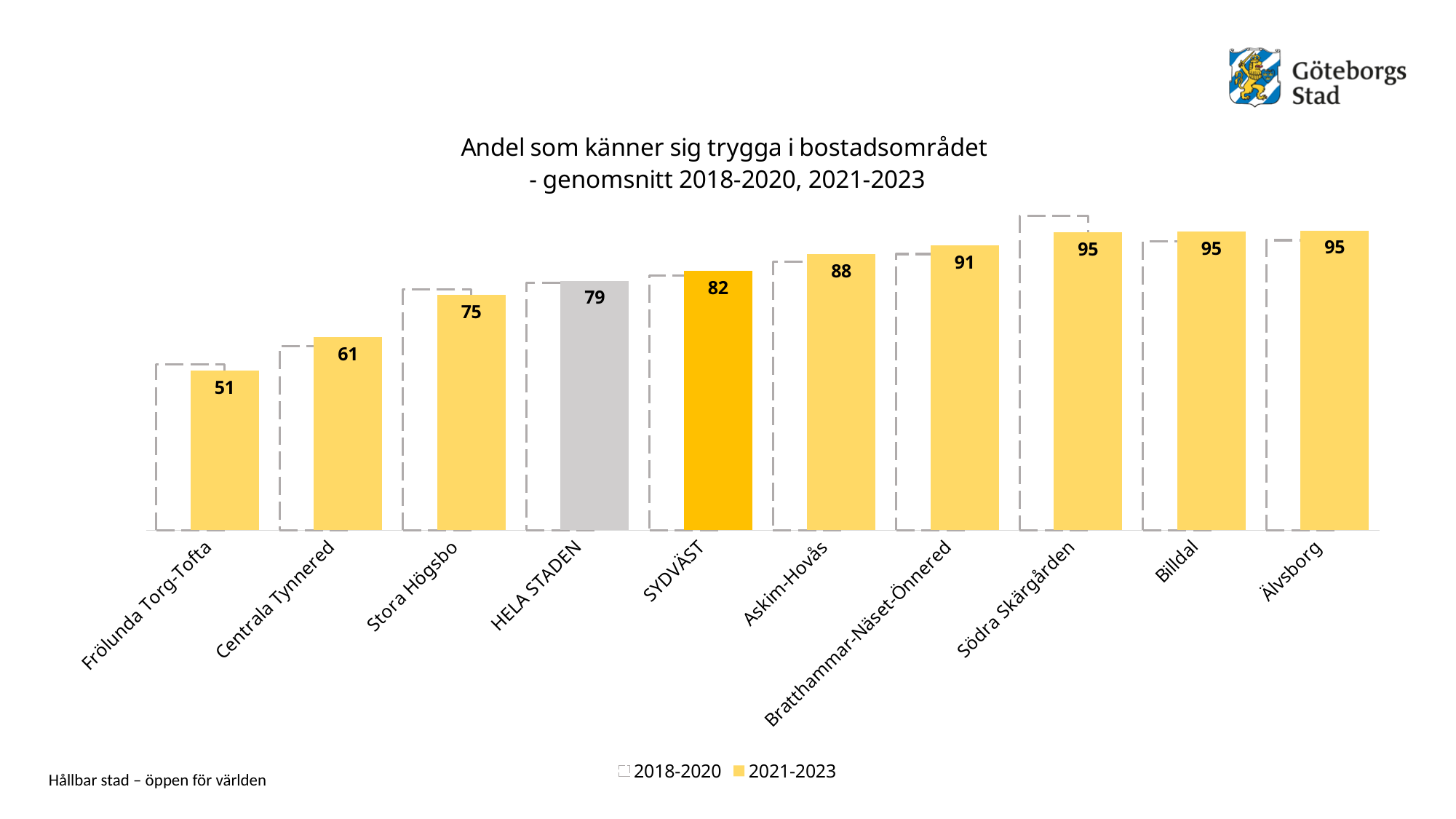
How many areas are shown on the x axis? 10 Which area has the lowest 2021-2023 value? Frölunda Torg-Tofta Which has a larger 2021-2023 value, Stora Högsbo or SYDVÄST? SYDVÄST What is the highest 2021-2023 value shown in the chart? 95 What is the 2021-2023 value for Frölunda Torg-Tofta? 51 What is the 2021-2023 value for SYDVÄST? 82 What is the 2021-2023 value for Bratthammar-Näset-Önnered? 91 For Södra Skärgården, which period has the higher value, 2018-2020 or 2021-2023? 2018-2020 What is the 2021-2023 value for HELA STADEN? 79 What kind of chart is shown on the slide? bar chart What is the difference between the 2021-2023 values for Askim-Hovås and Centrala Tynnered? 27 How many series does the legend list? 2